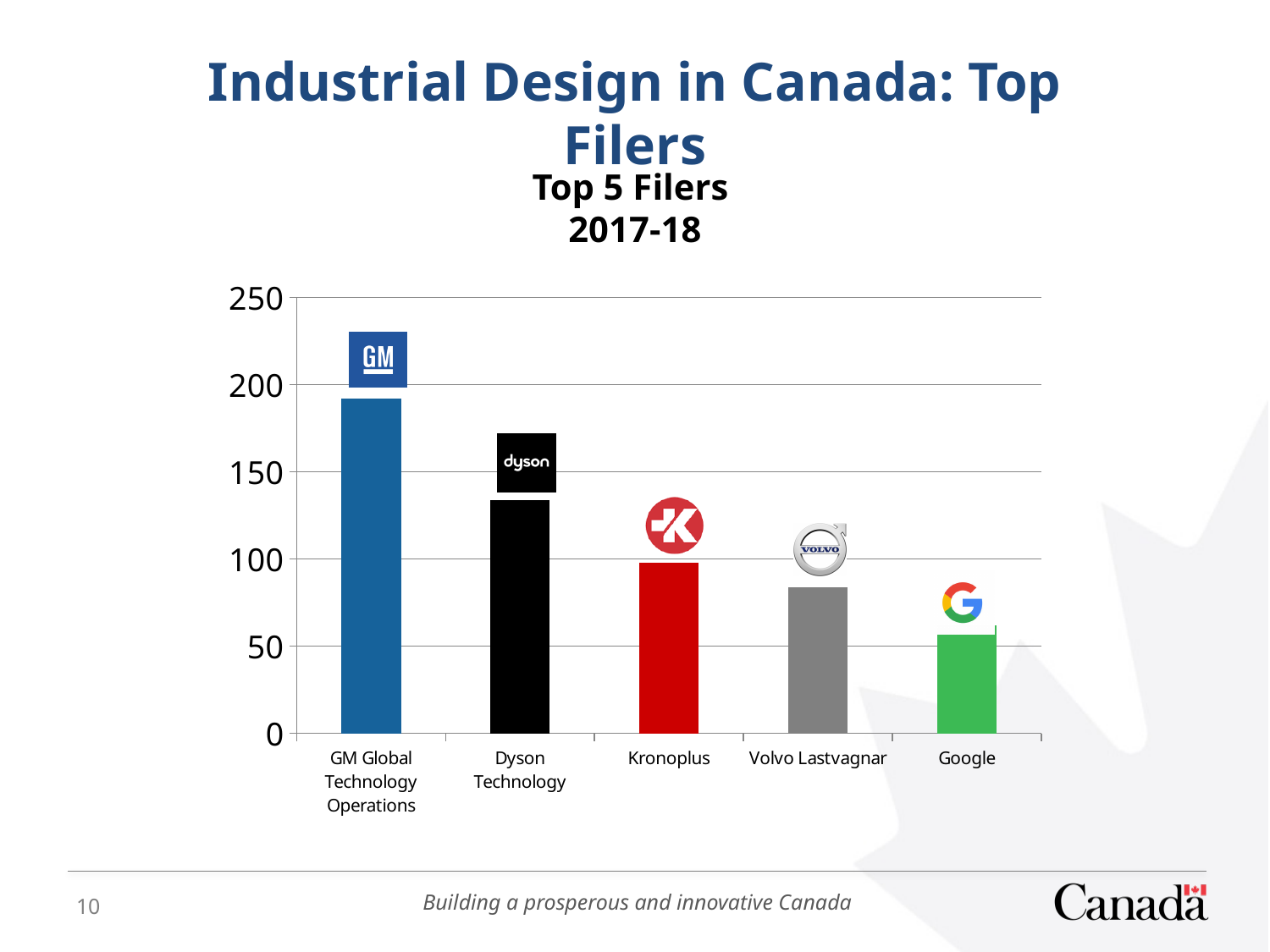
What kind of chart is shown on the slide? bar chart Is the value for GM Global Technology Operations greater or less than 150? greater What is the title of the chart? Top 5 Filers 2017-18 Is the value for Dyson Technology greater or less than 100? greater How many filers are shown in the chart? 5 Is the value for Volvo Lastvagnar greater or less than 100? less Do the values rise or fall moving from left to right across the chart? fall Which filer has the lowest number of filings? Google Which filer has the highest number of filings? GM Global Technology Operations Which has a larger value, Kronoplus or Volvo Lastvagnar? Kronoplus